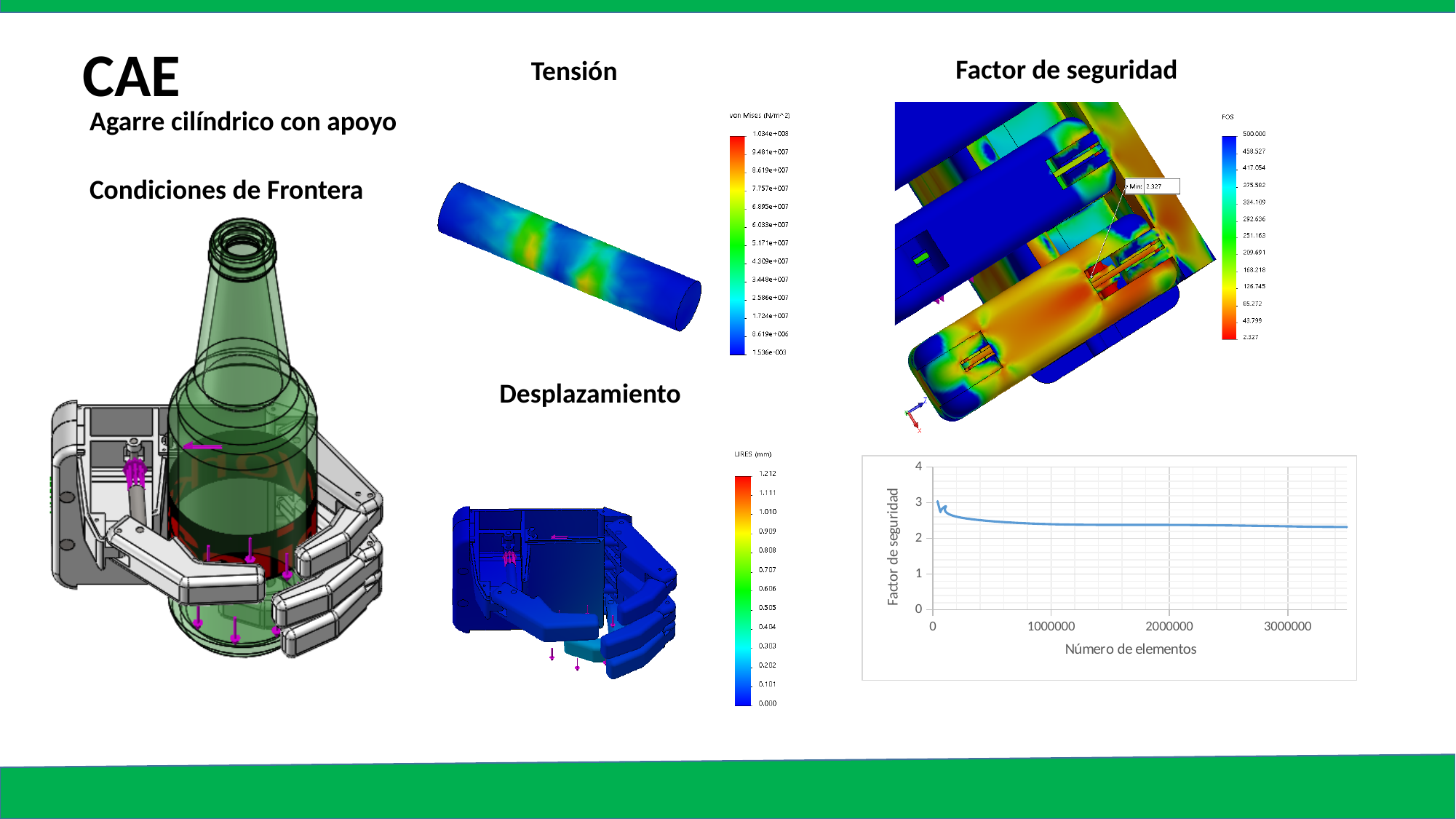
In the line chart at the bottom right, is the factor of safety at 2000000 elements greater or less than 2? greater In the line chart at the bottom right, is the factor of safety at 3000000 elements greater or less than 3? less In the line chart at the bottom right, is the factor of safety at 1000000 elements greater or less than 3? less What kind of chart is the chart at the bottom right of the slide? line chart In the line chart at the bottom right, does the factor of safety rise or fall as the number of elements increases? fall What is the label of the horizontal axis of the line chart at the bottom right? Número de elementos What is the label of the vertical axis of the line chart at the bottom right? Factor de seguridad In the line chart at the bottom right, what is the highest tick value shown on the vertical axis? 4 In the line chart at the bottom right, what is the highest tick value shown on the horizontal axis? 3000000 In the line chart at the bottom right, is the factor of safety higher at the start of the curve (near 0 elements) or at 3000000 elements? near 0 elements